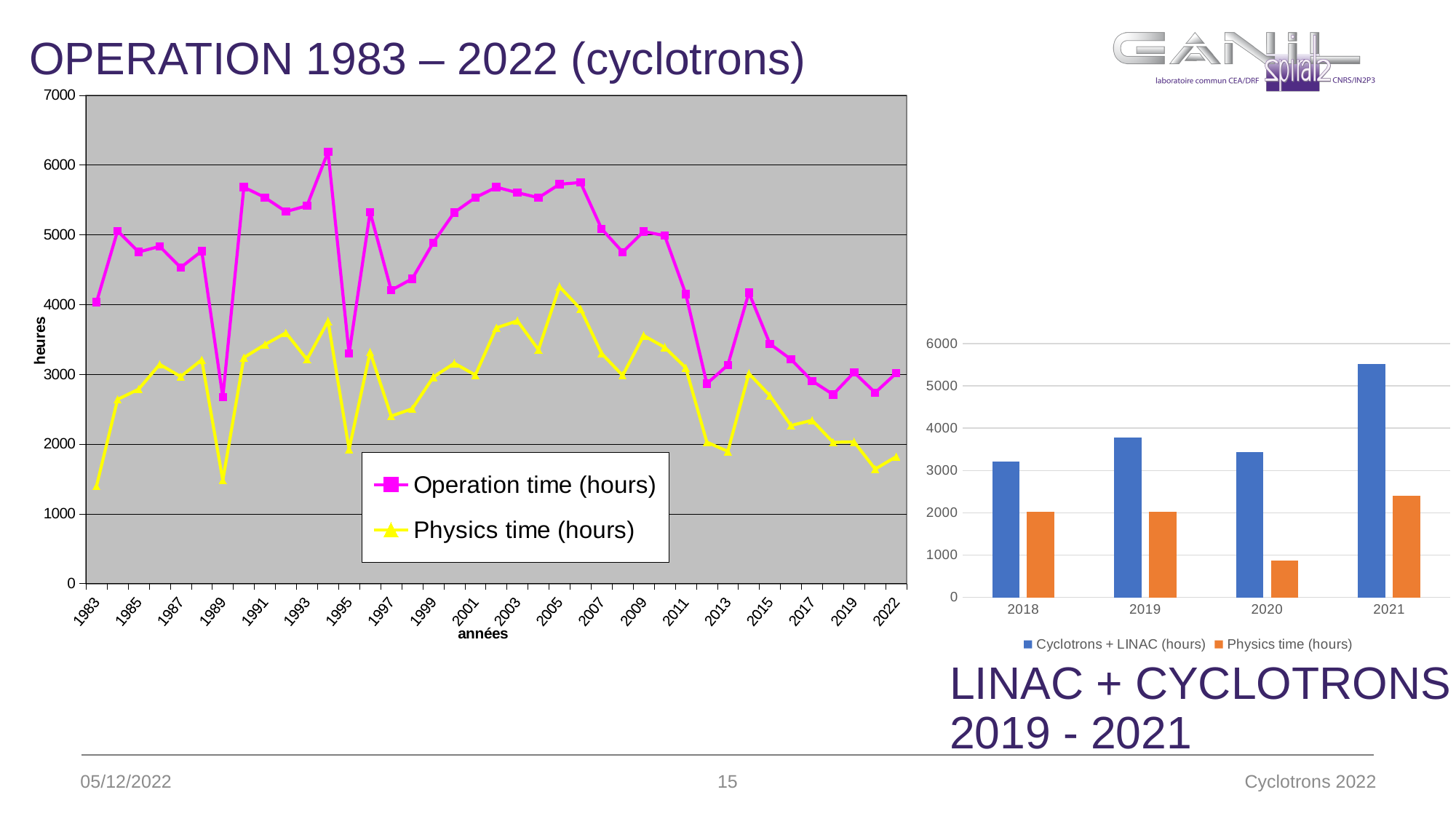
What kind of chart is the right chart labelled 'LINAC + CYCLOTRONS 2019 - 2021'? bar chart In the right chart 'LINAC + CYCLOTRONS 2019 - 2021', which year has the highest Cyclotrons + LINAC (hours) value? 2021 In the right chart 'LINAC + CYCLOTRONS 2019 - 2021', is the Physics time (hours) value for 2020 greater or less than 1000? less In the left chart 'OPERATION 1983 – 2022 (cyclotrons)', what is the label of the y axis? heures In the right chart 'LINAC + CYCLOTRONS 2019 - 2021', which year has the lowest Physics time (hours) value? 2020 In the left chart 'OPERATION 1983 – 2022 (cyclotrons)', in which year is Operation time (hours) highest? 1994 In the left chart 'OPERATION 1983 – 2022 (cyclotrons)', how many series does the legend list? 2 In the right chart 'LINAC + CYCLOTRONS 2019 - 2021', how many years are shown on the x axis? 4 What kind of chart is the left chart titled 'OPERATION 1983 – 2022 (cyclotrons)'? line chart In the left chart 'OPERATION 1983 – 2022 (cyclotrons)', in which year is Physics time (hours) highest? 2005 In the left chart 'OPERATION 1983 – 2022 (cyclotrons)', is the Operation time (hours) value for 1994 greater or less than 6000? greater In the left chart 'OPERATION 1983 – 2022 (cyclotrons)', is the Operation time (hours) value for 1989 greater or less than 3000? less